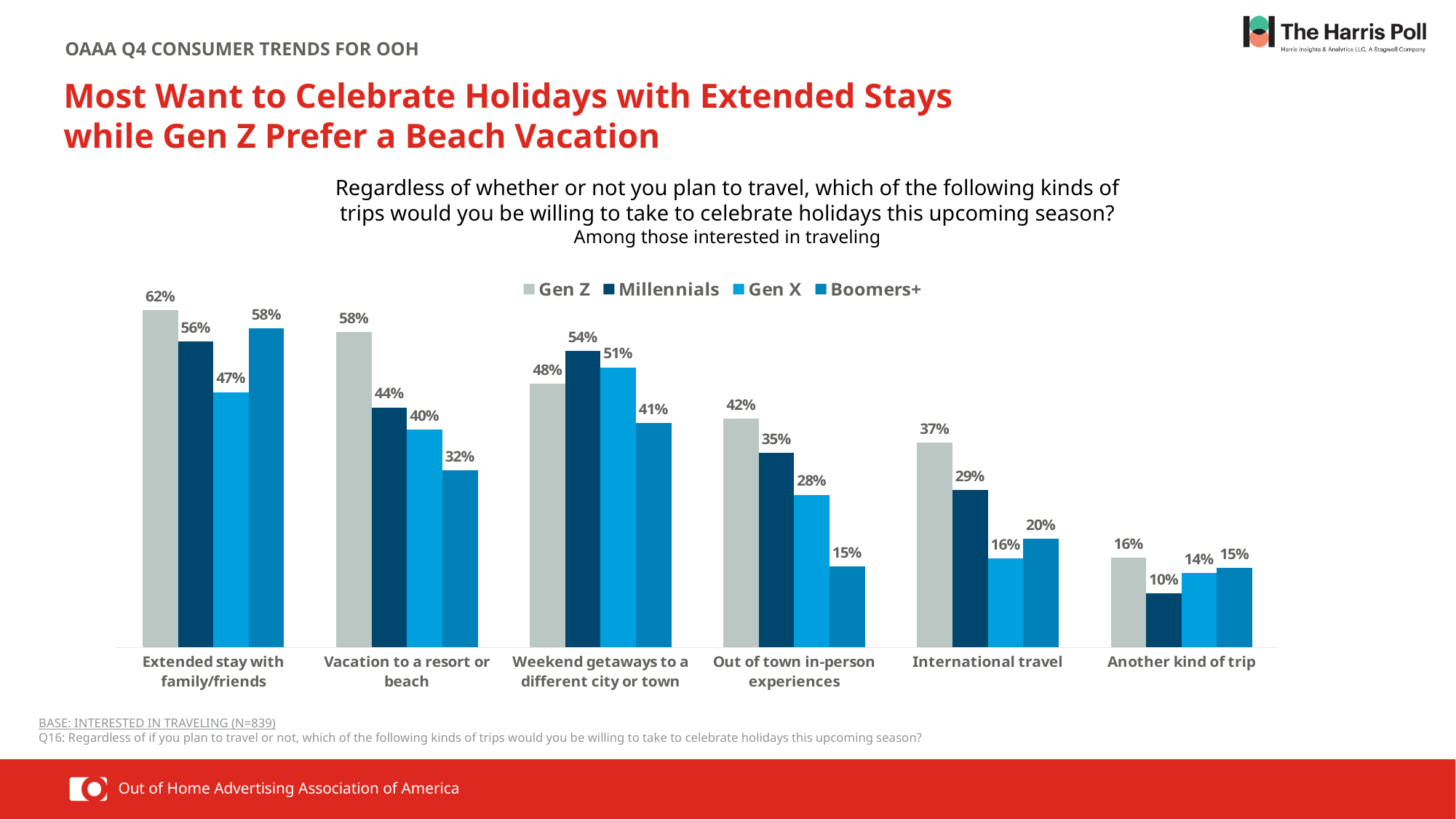
Do the Gen Z values rise or fall moving from left to right across the categories? Fall What is the Millennials value for weekend getaways to a different city or town? 54% Which trip type has the lowest Millennials value? Another kind of trip Which trip type has the highest Gen X value? Weekend getaways to a different city or town What is the difference between the Gen Z and Boomers+ values for out of town in-person experiences? 27 percentage points Which series is shown in the lightest grey colour in the legend? Gen Z For international travel, which is larger: the Gen X value or the Boomers+ value? Boomers+ What percentage of Gen Z would be willing to take an extended stay with family/friends? 62% How many trip categories are shown on the x axis? 6 How many series does the legend list? 4 What is the Boomers+ value for vacation to a resort or beach? 32% What kind of chart is shown on the slide? Bar chart